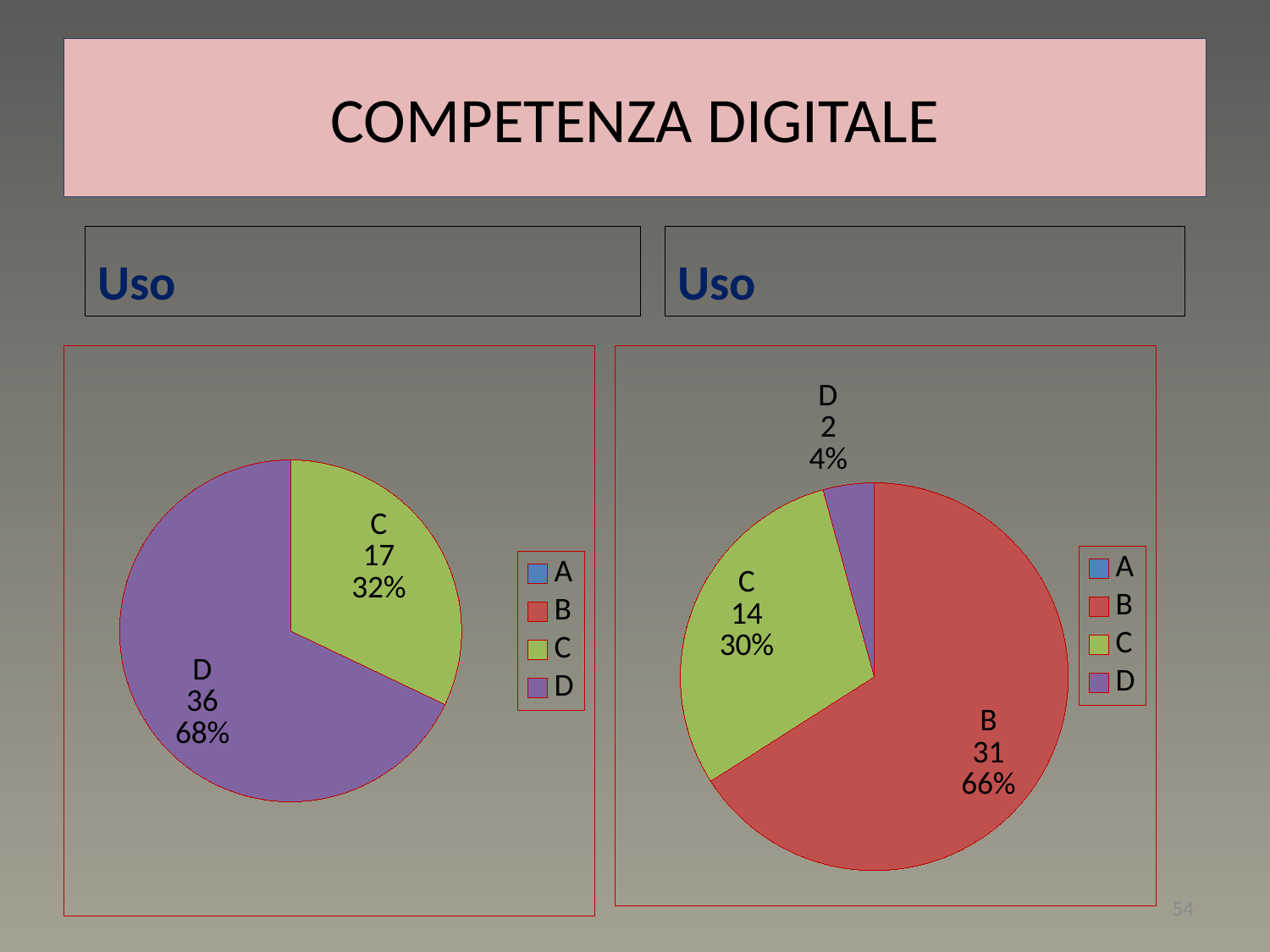
In the right pie chart, what share of the pie does category D have? 4% What kind of chart is the left chart? Pie chart In the right pie chart, what is the value for category B? 31 In the left pie chart, what is the value for category D? 36 In the left pie chart, what is the difference between the values for D and C? 19 In the left pie chart, which category has the larger slice, C or D? D How many entries does the legend of the right chart list? 4 In the left pie chart, what share of the pie does category C have? 32% In the right pie chart, which category has the largest slice? B In the right pie chart, what is the difference between the values for B and C? 17 In the right pie chart, which category has the smallest slice? D In the right pie chart, what is the value for category C? 14